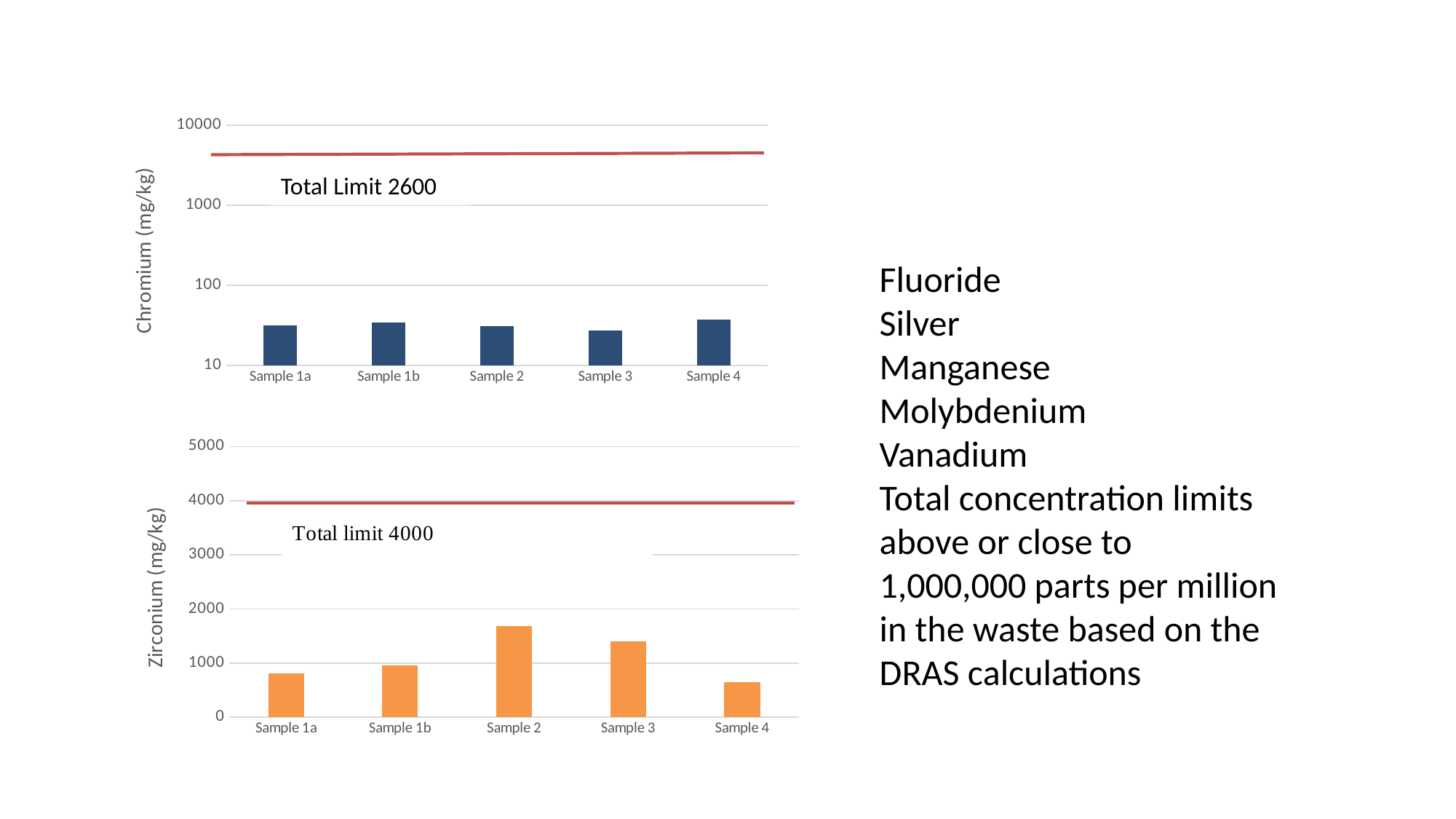
In the top chart (Chromium), is the value for Sample 4 greater or less than 100? less In the top chart (Chromium), which sample has the highest value? Sample 4 How many samples are plotted in the bottom chart (Zirconium)? 5 In the bottom chart (Zirconium), is the value for Sample 2 greater or less than 2000? less In the bottom chart (Zirconium), is the value for Sample 2 greater or less than 1000? greater In the bottom chart (Zirconium), which is larger, the value for Sample 2 or the value for Sample 3? Sample 2 What total limit is labelled on the top chart (Chromium)? Total Limit 2600 What type of chart is the top chart (Chromium)? bar chart In the bottom chart (Zirconium), which sample has the highest value? Sample 2 What is the y-axis label of the bottom chart? Zirconium (mg/kg) In the bottom chart (Zirconium), which sample has the lowest value? Sample 4